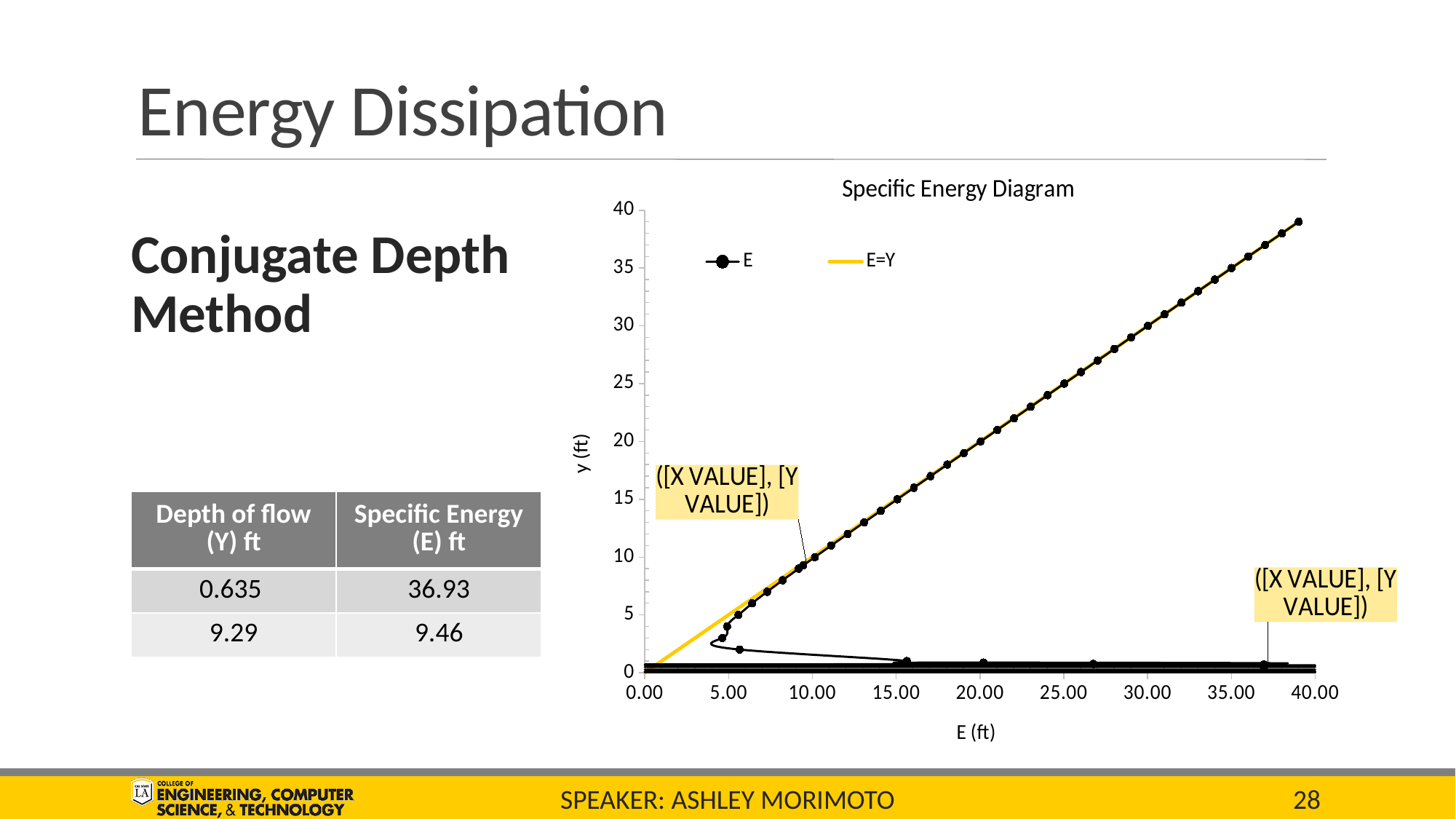
What is the maximum value shown on the y axis of the chart? 40 Is the y (ft) value of the E=Y line at E = 20.00 ft greater or less than 15? greater Is the y (ft) value of the E=Y line at E = 10.00 ft greater or less than 15? less Does the E=Y line rise or fall as E (ft) increases along the x axis? rises What is the title of the chart? Specific Energy Diagram How many series does the chart legend list? 2 What are the names of the two series in the chart legend? E and E=Y What kind of chart is shown on the slide? line chart Is the y (ft) value of the E series point near E = 37 ft on the lower branch greater or less than 5? less What is the maximum value shown on the x axis of the chart? 40.00